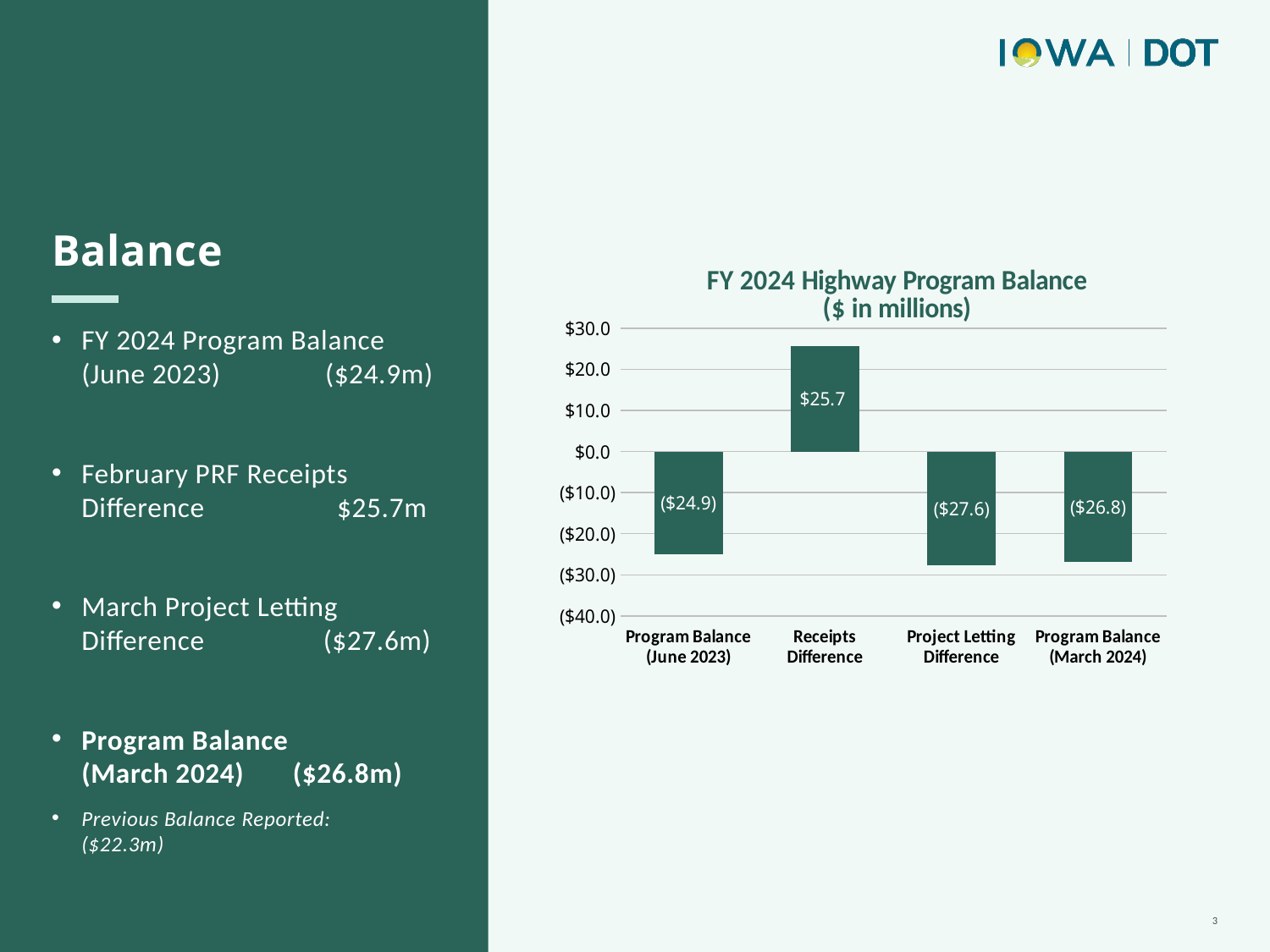
Is the value for Receipts Difference greater or less than $20.0? greater How many bars are plotted in the chart? 4 What value is shown for Program Balance (March 2024) in the chart? ($26.8) Which category in the chart has the lowest value? Project Letting Difference What is the value of the Receipts Difference bar in the FY 2024 Highway Program Balance chart? $25.7 What is the difference between the Project Letting Difference value and the Program Balance (March 2024) value? $0.8 What kind of chart is shown on the slide? bar chart Which is larger: the value for Program Balance (June 2023) or Program Balance (March 2024)? Program Balance (June 2023) What value is shown for Project Letting Difference in the chart? ($27.6) Which category in the chart has the highest value? Receipts Difference What value is shown for Program Balance (June 2023) in the chart? ($24.9) What is the title of the chart on the slide? FY 2024 Highway Program Balance ($ in millions)